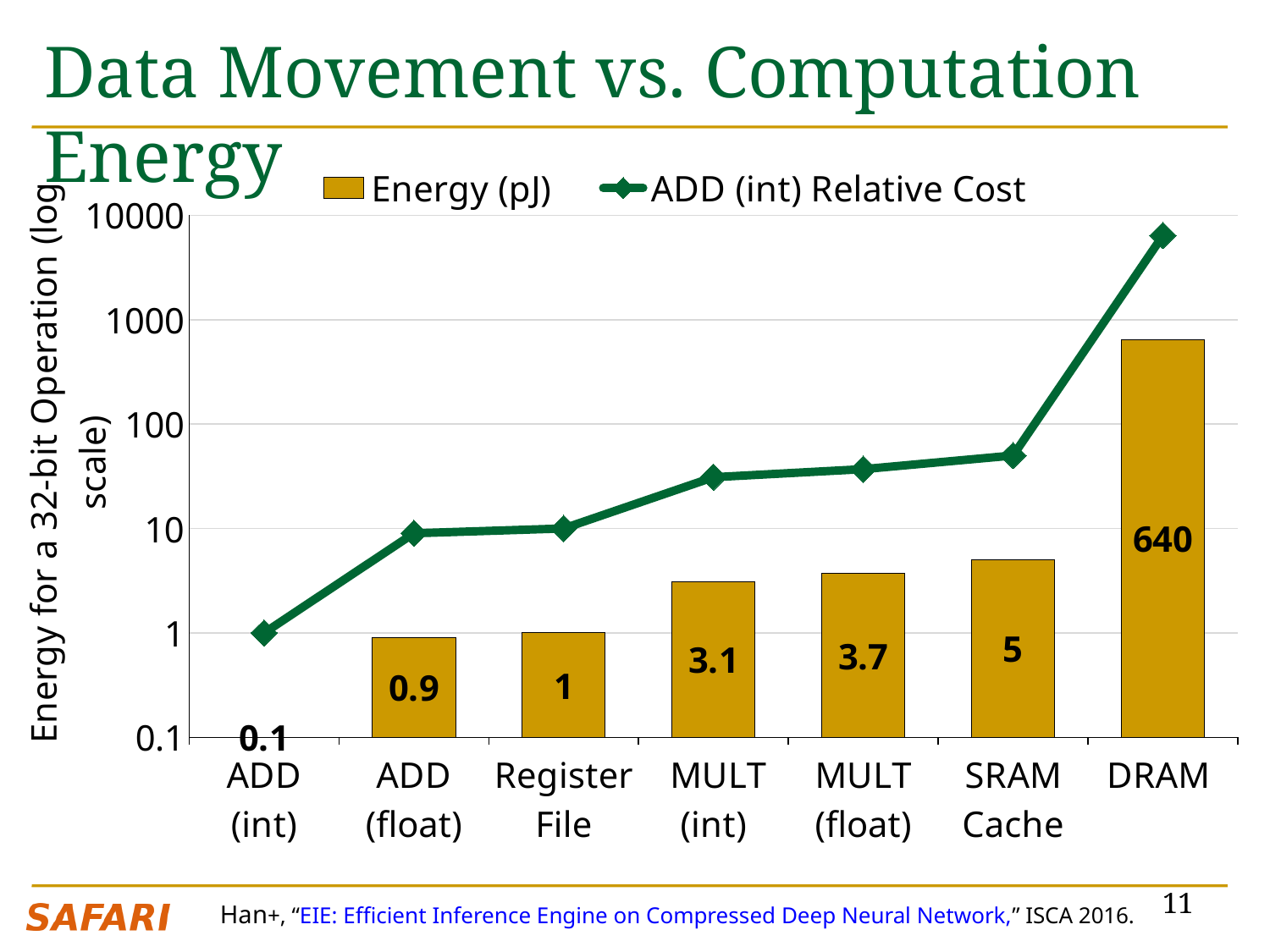
What is the Energy (pJ) value for SRAM Cache? 5 Which has a higher Energy (pJ) value, MULT (int) or ADD (float)? MULT (int) What is the Energy (pJ) value for DRAM? 640 What is the difference in Energy (pJ) between DRAM and SRAM Cache? 635 Is the ADD (int) Relative Cost value for SRAM Cache greater or less than 100? less What is the difference in Energy (pJ) between MULT (float) and MULT (int)? 0.6 How many series does the legend list? 2 Which category has the lowest Energy (pJ) value? ADD (int) Is the ADD (int) Relative Cost value for DRAM greater or less than 1000? greater Which category has the highest Energy (pJ) value? DRAM What is the Energy (pJ) value for MULT (float)? 3.7 How many categories are shown on the x axis? 7